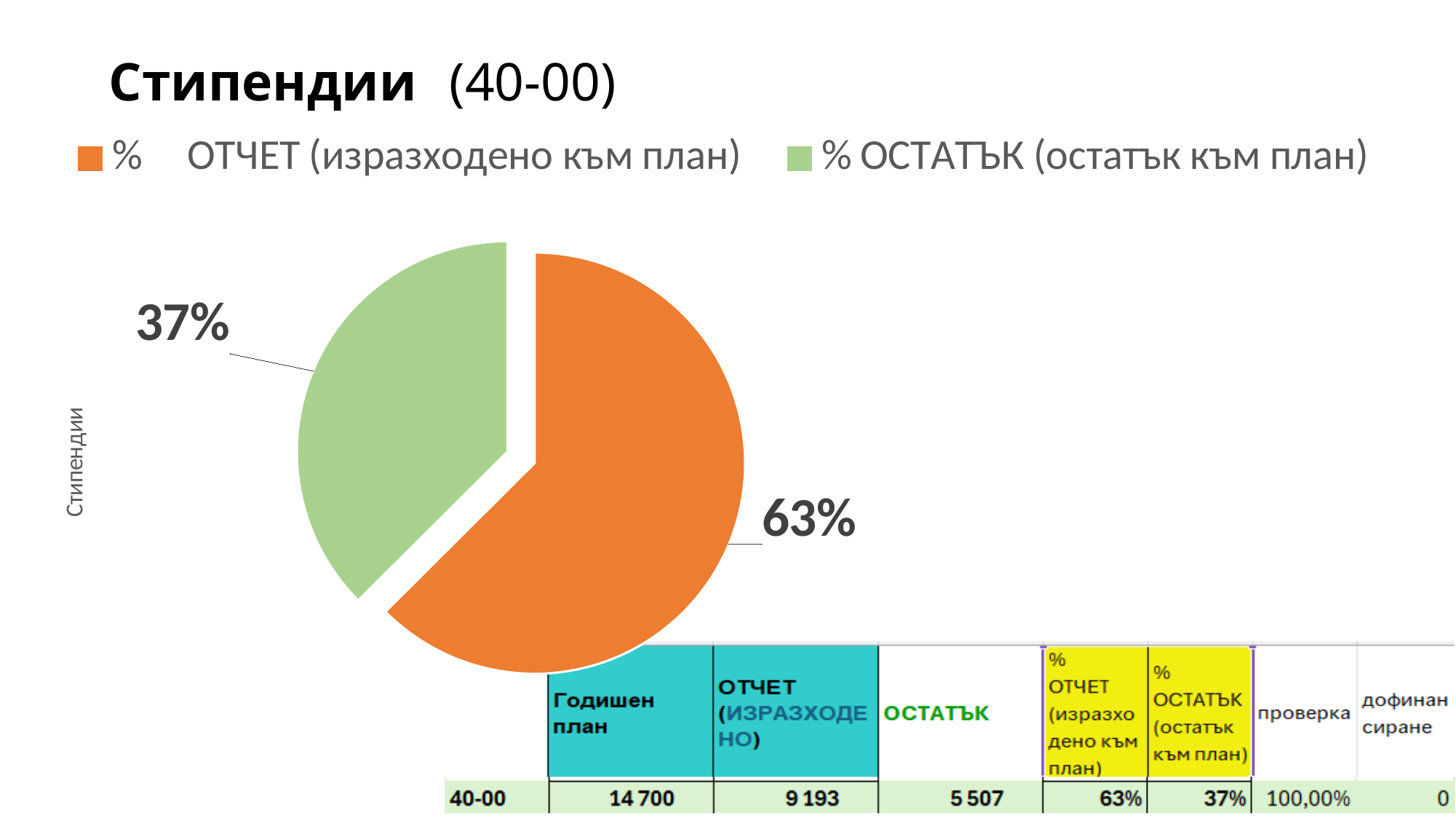
Which is larger, the "% ОТЧЕТ" slice or the "% ОСТАТЪК" slice? % ОТЧЕТ What is the difference in percentage points between the "% ОТЧЕТ" slice and the "% ОСТАТЪК" slice? 26 How many slices does the pie chart have? 2 Which slice of the pie is the smallest? % ОСТАТЪК (остатък към план) What share of the pie does the "% ОТЧЕТ (изразходено към план)" slice represent? 63% What kind of chart is shown on the slide? pie chart What share of the pie does the "% ОСТАТЪК (остатък към план)" slice represent? 37% What is the title of the chart? Стипендии (40-00) What colour is the "% ОСТАТЪК (остатък към план)" slice? green Is the share of the "% ОТЧЕТ" slice greater or less than 50%? greater Which slice of the pie is the largest? % ОТЧЕТ (изразходено към план) How many entries does the legend list? 2